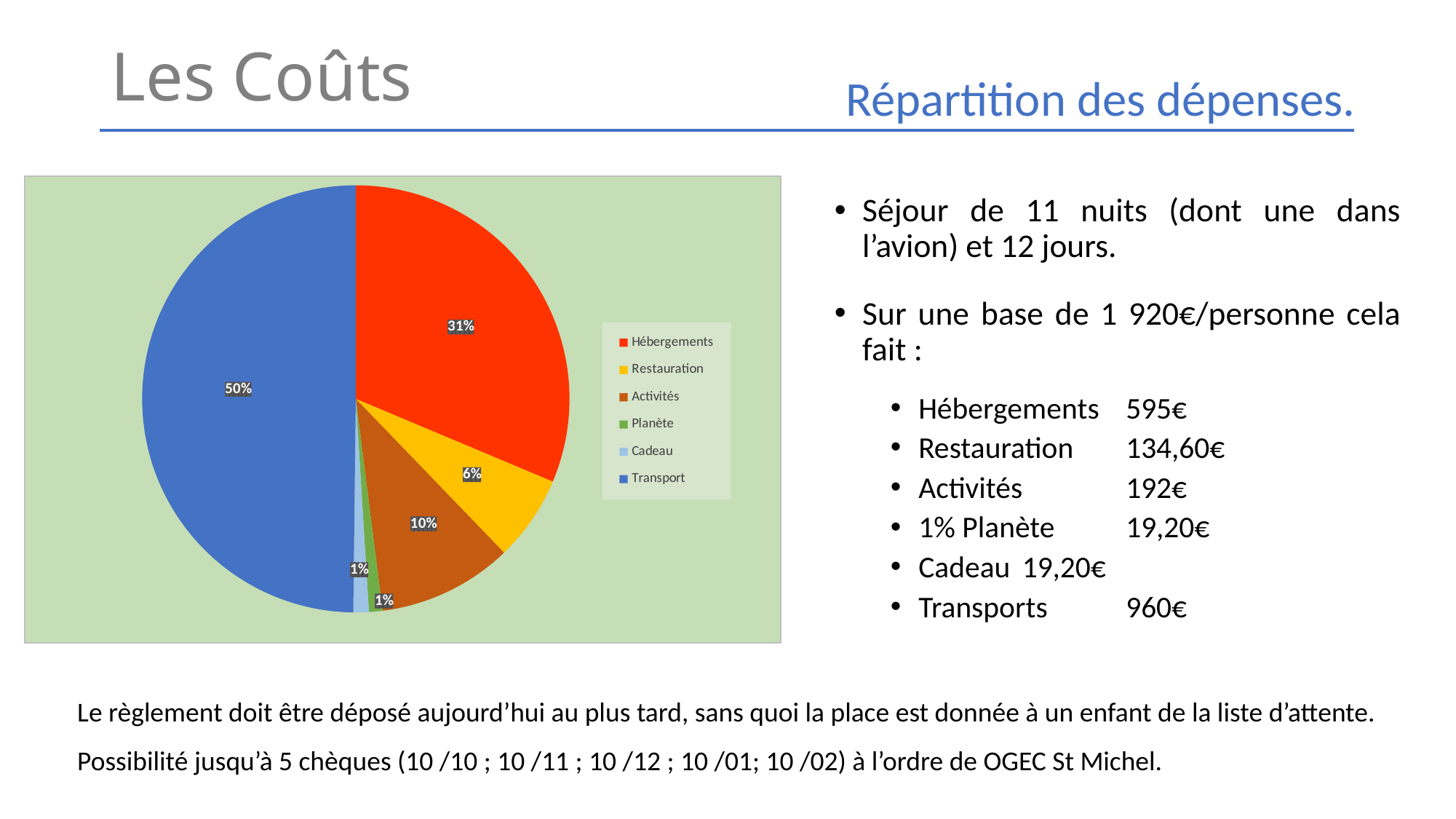
What share of the pie does Activités represent? 10% What share of the pie does Cadeau represent? 1% Which category has the largest slice of the pie? Transport What is the difference in percentage points between the Transport slice and the Hébergements slice? 19 Which slice is larger, Activités or Restauration? Activités What share of the pie does Hébergements represent? 31% Which legend entry is shown in red? Hébergements What kind of chart is shown on the slide? pie chart What share of the pie does Restauration represent? 6% How many categories does the pie chart legend list? 6 What colour is the Transport slice in the pie chart? blue What share of the pie does Transport represent? 50%